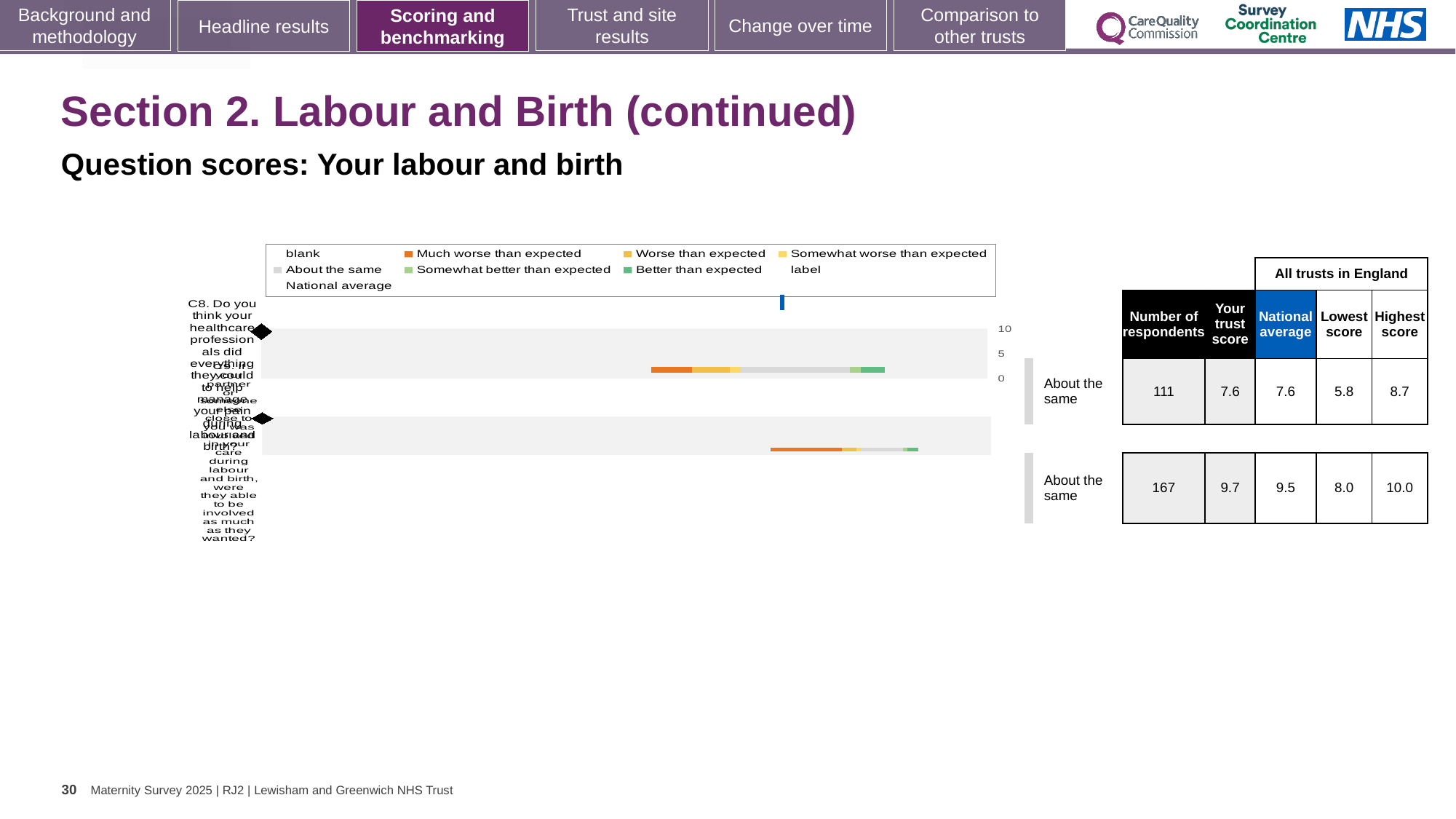
In the table to the right of the chart, what is the national average for the first question row (C8)? 7.6 What benchmark category is shown for both question rows next to the chart? About the same In the table to the right of the chart, what is the highest score for the second question row? 10.0 In the table to the right of the chart, what is 'Your trust score' for the second question row? 9.7 What kind of chart is shown on the slide? bar chart In the chart legend, what colour represents 'Better than expected'? green In the table to the right of the chart, what is the number of respondents for the first question row (C8)? 111 In the table to the right of the chart, what is the lowest score for the first question row (C8)? 5.8 Which question row has more respondents in the table to the right of the chart, the first (C8) or the second? the second What is the difference in number of respondents between the second question row and the first question row (C8) in the table? 56 How many question rows (bars) are plotted in the chart? 2 In the chart legend, what colour represents 'Much worse than expected'? orange